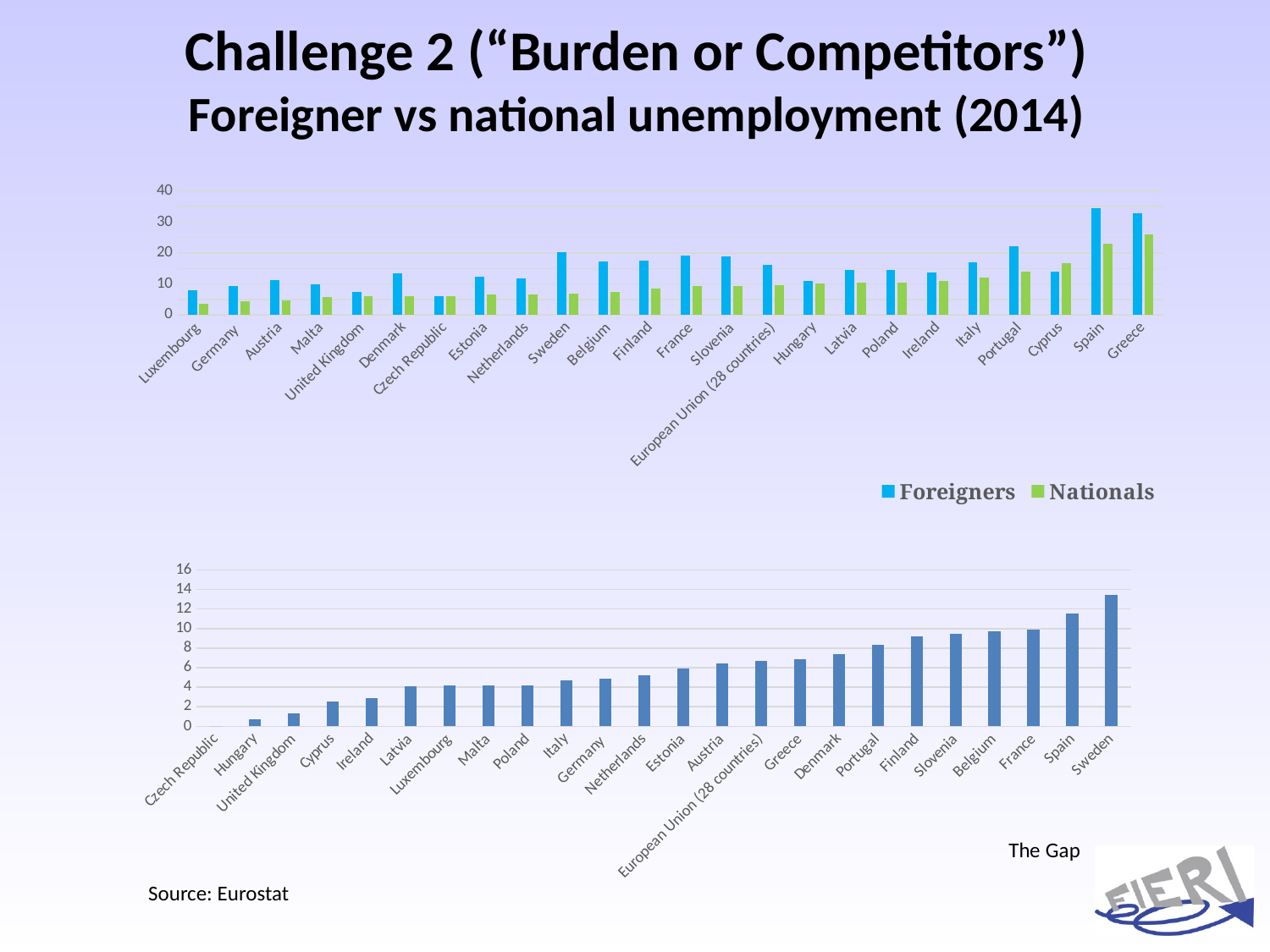
In the top chart, is the Foreigners value for Luxembourg greater or less than 10? less In the bottom chart (The Gap), do the values rise or fall from left to right along the x axis? rise What kind of chart is the top chart (Foreigner vs national unemployment)? bar chart In the bottom chart (The Gap), which country has the highest value? Sweden In the bottom chart (The Gap), which country has the lowest value? Czech Republic In the top chart, which country has the highest Nationals value? Greece In the top chart, is the Foreigners value for Spain greater or less than 30? greater In the bottom chart (The Gap), is the value for Hungary greater or less than 2? less How many series does the legend of the top chart list? 2 How many countries/categories are shown on the top chart? 24 What are the two series named in the legend of the top chart? Foreigners and Nationals